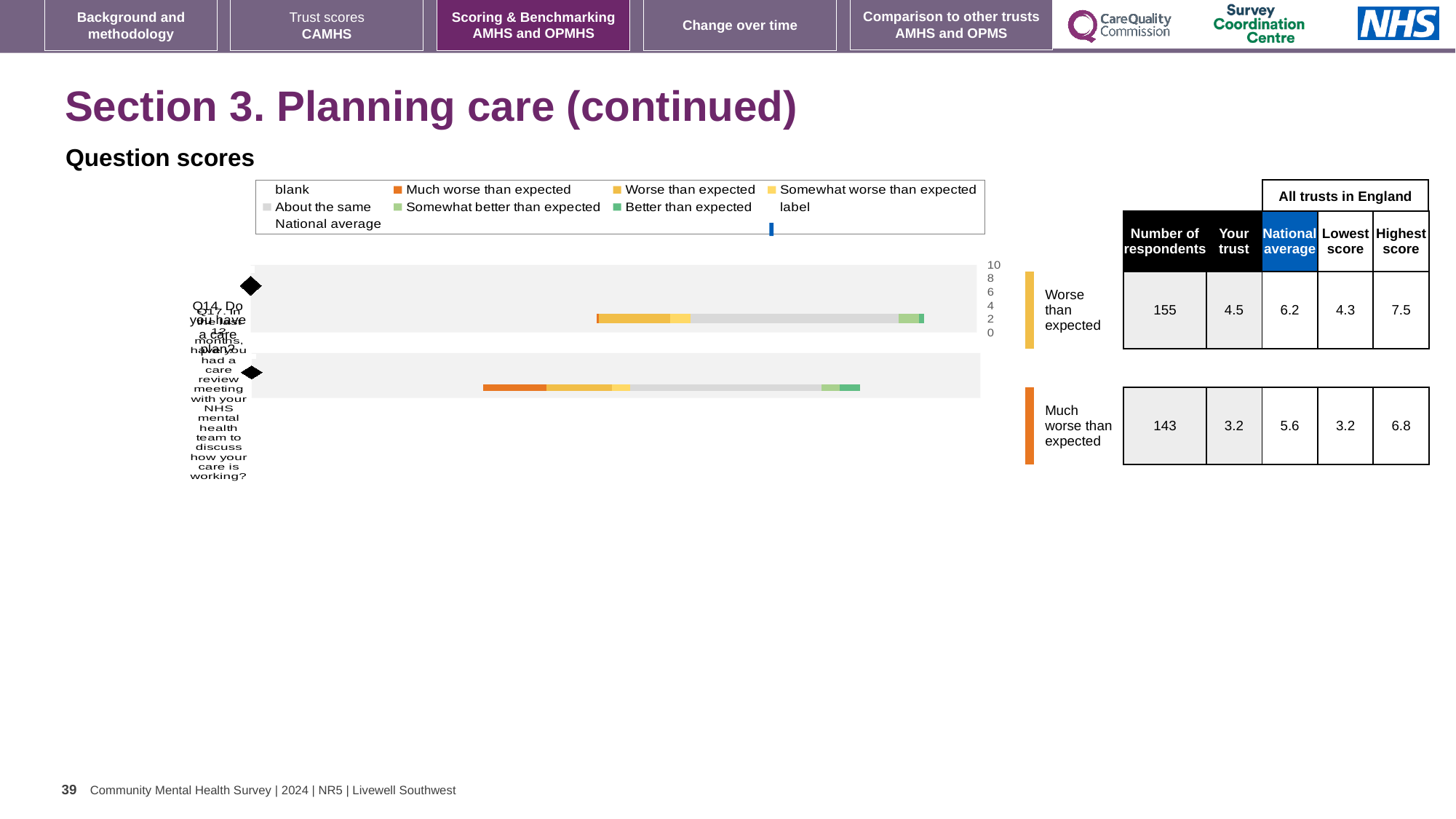
How many question bars are plotted in the chart? 2 What is the highest score among all trusts in England for the bottom bar, the question rated 'Much worse than expected'? 6.8 What is the national average for the top bar, the question rated 'Worse than expected'? 6.2 What kind of chart is shown under 'Question scores'? bar chart What is the number of respondents for the bottom bar, the question rated 'Much worse than expected'? 143 What rating label is shown next to the bottom bar? Much worse than expected For the top bar (rated 'Worse than expected'), what is the difference between the highest and lowest scores among all trusts in England? 3.2 What is the 'Your trust' score for the top bar, the question rated 'Worse than expected'? 4.5 What colour does the legend use for 'Much worse than expected'? orange Which bar has the higher 'Your trust' score, the top one or the bottom one? the top one Which bar has more respondents, the top one or the bottom one? the top one For the bottom bar (rated 'Much worse than expected'), how much lower is the trust's score than the national average? 2.4